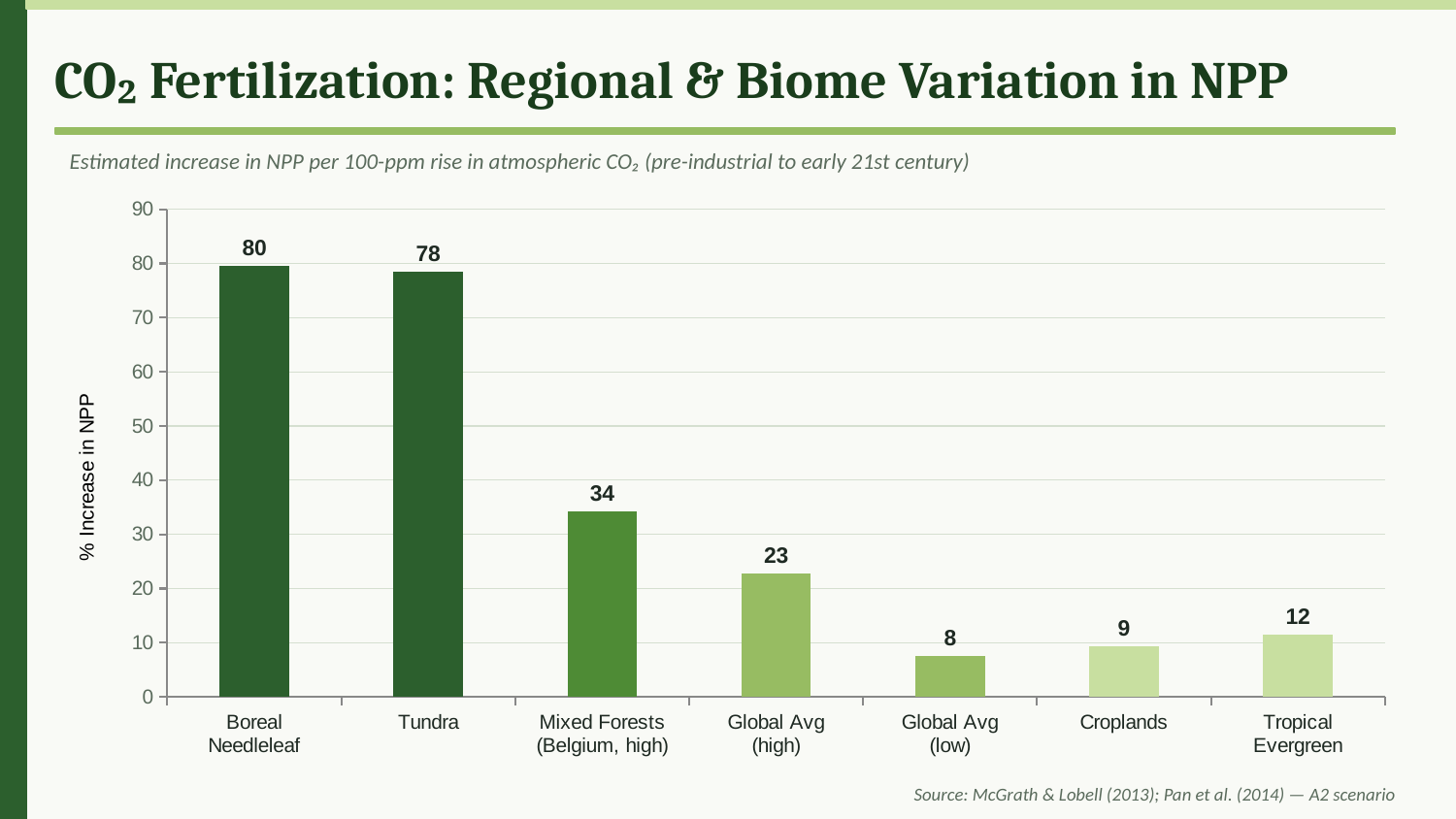
Which category has the lowest % increase in NPP? Global Avg (low) Which category has the highest % increase in NPP? Boreal Needleleaf What is the % increase in NPP for Boreal Needleleaf? 80 What is the difference between the values for Boreal Needleleaf and Tundra? 2 What is the % increase in NPP for Mixed Forests (Belgium, high)? 34 What kind of chart is shown on the slide? Bar chart Which is larger, the value for Croplands or the value for Tropical Evergreen? Tropical Evergreen How many categories are shown on the x axis? 7 What is the value for Global Avg (low)? 8 Is the value for Tundra greater or less than 70? greater What is the difference between the values for Global Avg (high) and Global Avg (low)? 15 What is the label of the y axis? % Increase in NPP